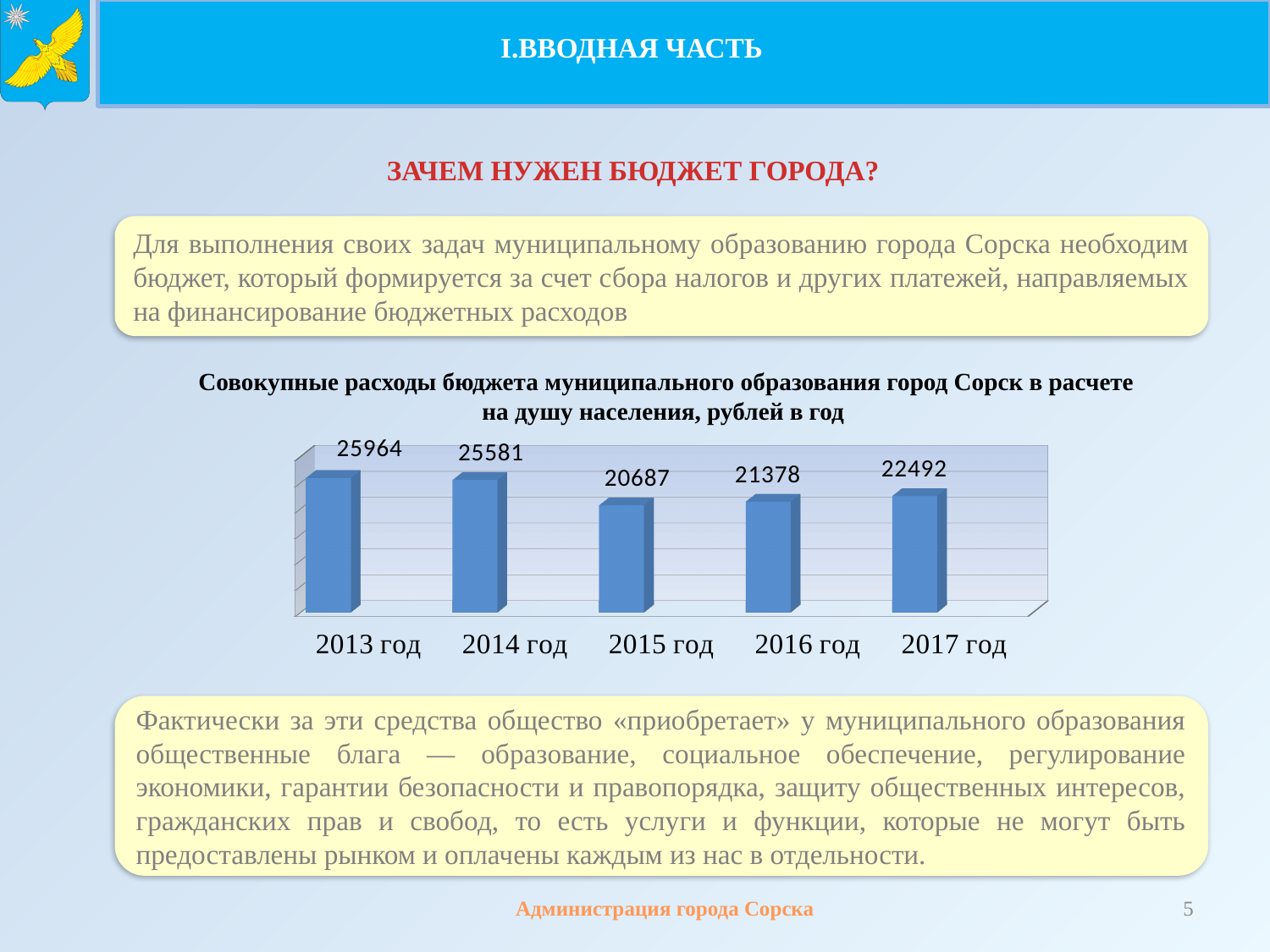
Which is larger, the value for 2016 год or the value for 2015 год? 2016 год How many years are shown on the chart? 5 What is the value for 2013 год? 25964 Which year has the highest value? 2013 год What kind of chart is shown on the slide? bar chart Which year has the lowest value? 2015 год What is the difference between the values for 2017 год and 2016 год? 1114 What is the title of the chart? Совокупные расходы бюджета муниципального образования город Сорск в расчете на душу населения, рублей в год What is the value for 2017 год? 22492 What is the difference between the values for 2013 год and 2014 год? 383 Do the values rise or fall from 2015 год to 2017 год? rise What is the value for 2015 год? 20687